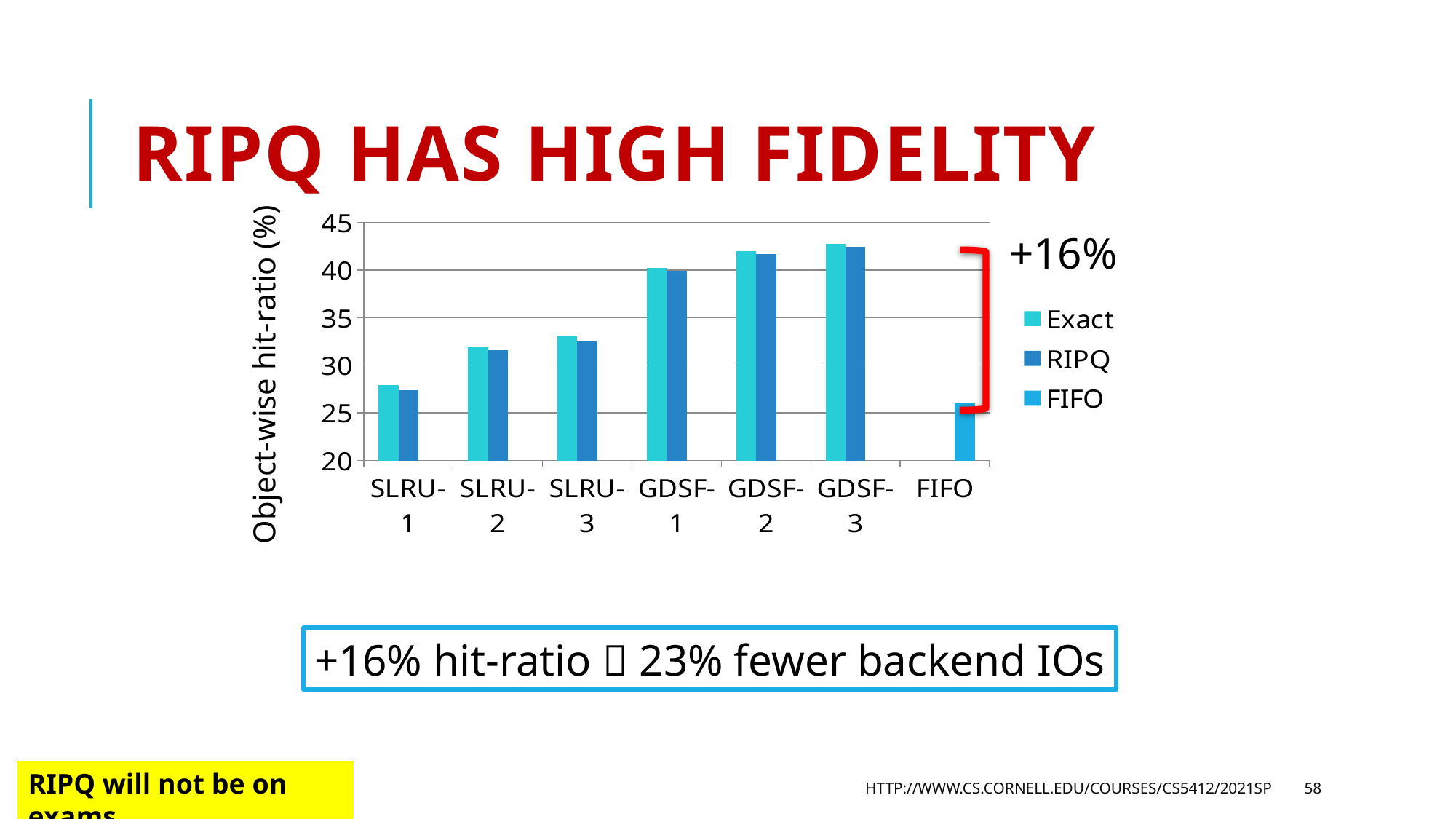
Is the Exact value for GDSF-2 greater or less than 40? greater Which category has the highest Exact value? GDSF-3 How many categories are shown along the x axis of the chart? 7 Which is larger, the Exact value for GDSF-1 or the Exact value for SLRU-3? GDSF-1 What kind of chart is shown on the slide? bar chart Which category has the lowest Exact value? SLRU-1 Is the FIFO value greater or less than 30? less Do the Exact values rise or fall from SLRU-1 to GDSF-3 along the x axis? rise How many series does the chart's legend list? 3 Is the RIPQ value for SLRU-3 greater or less than 30? greater What is the label of the chart's y axis? Object-wise hit-ratio (%)